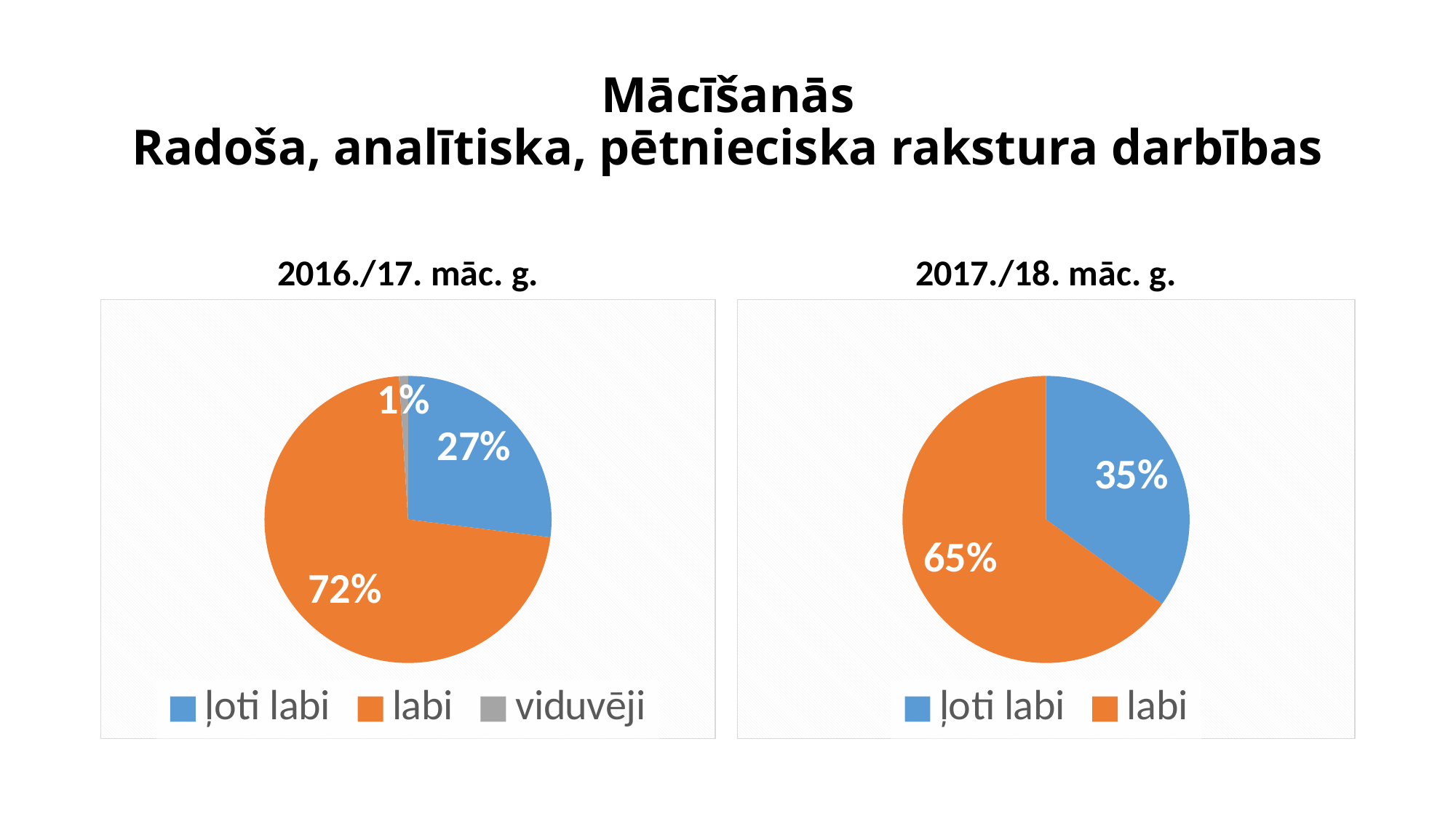
In the 2016./17. māc. g. chart, what share does the 'viduvēji' slice have? 1% In the 2016./17. māc. g. chart, which category has the smallest slice? viduvēji In the 2016./17. māc. g. chart, what share does the 'labi' slice have? 72% What kind of chart is the 2017./18. māc. g. chart? pie chart How many categories does the legend of the 2016./17. māc. g. chart list? 3 In the 2017./18. māc. g. chart, which category has the largest slice? labi In the 2016./17. māc. g. chart, what share does the 'ļoti labi' slice have? 27% In the 2017./18. māc. g. chart, what is the difference between the 'labi' and 'ļoti labi' shares? 30% In the 2016./17. māc. g. chart, which category has the largest slice? labi In the 2017./18. māc. g. chart, what share does the 'ļoti labi' slice have? 35% Which is larger: the 'ļoti labi' share in the 2016./17. māc. g. chart or in the 2017./18. māc. g. chart? 2017./18. māc. g. In the 2017./18. māc. g. chart, what share does the 'labi' slice have? 65%